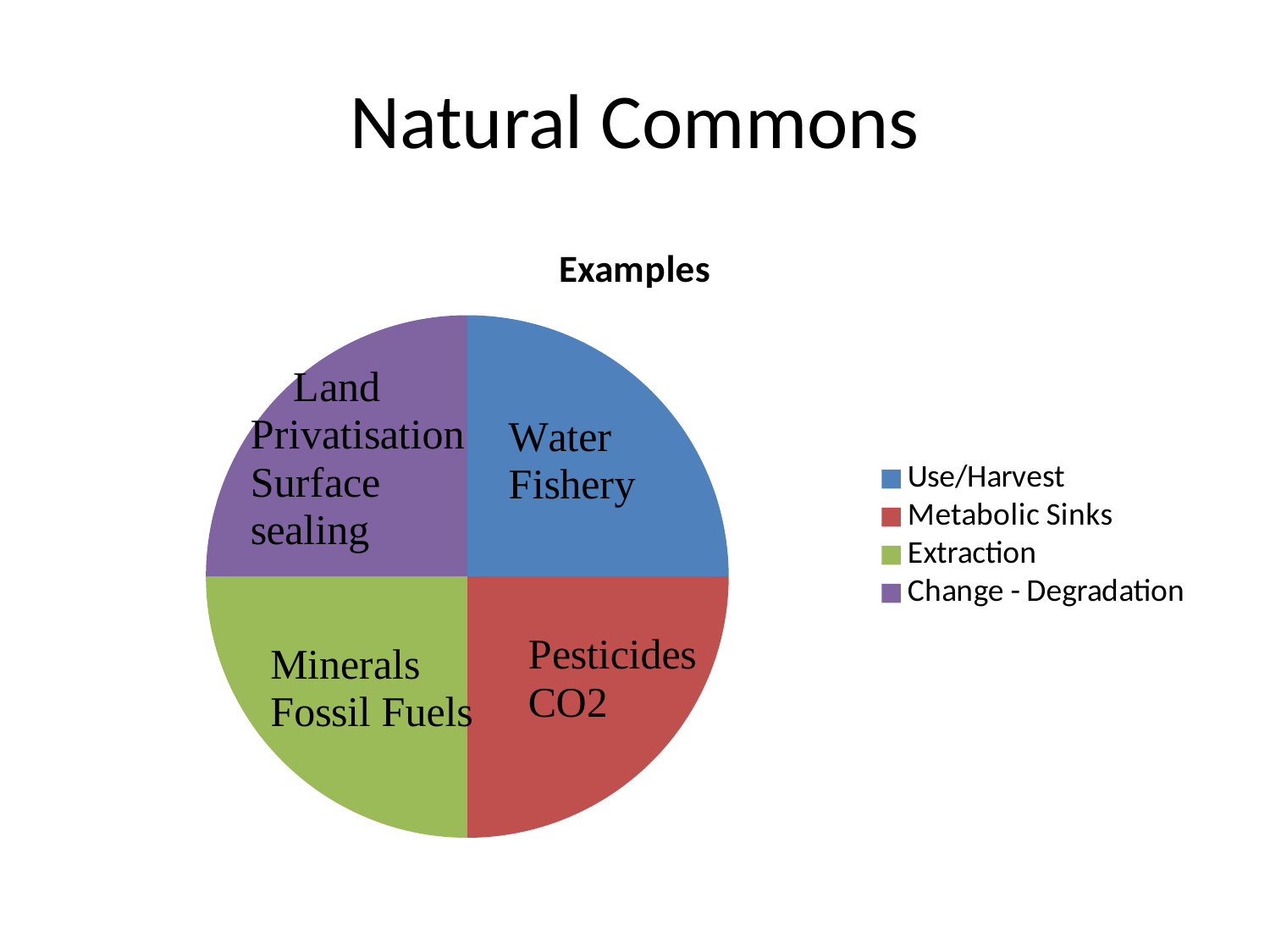
What is the title of the pie chart? Examples Which legend category does the slice labelled "Pesticides CO2" belong to? Metabolic Sinks Which legend category does the slice labelled "Minerals Fossil Fuels" belong to? Extraction What kind of chart is shown on the slide? Pie chart What examples are written on the Metabolic Sinks slice of the pie chart? Pesticides, CO2 What examples are written on the Extraction slice of the pie chart? Minerals, Fossil Fuels Which legend category is shown in blue on the pie chart? Use/Harvest Which legend category does the slice labelled "Water Fishery" belong to? Use/Harvest How many slices does the pie chart have? 4 How many entries does the legend of the pie chart list? 4 Which legend category does the slice labelled "Land Privatisation Surface sealing" belong to? Change - Degradation